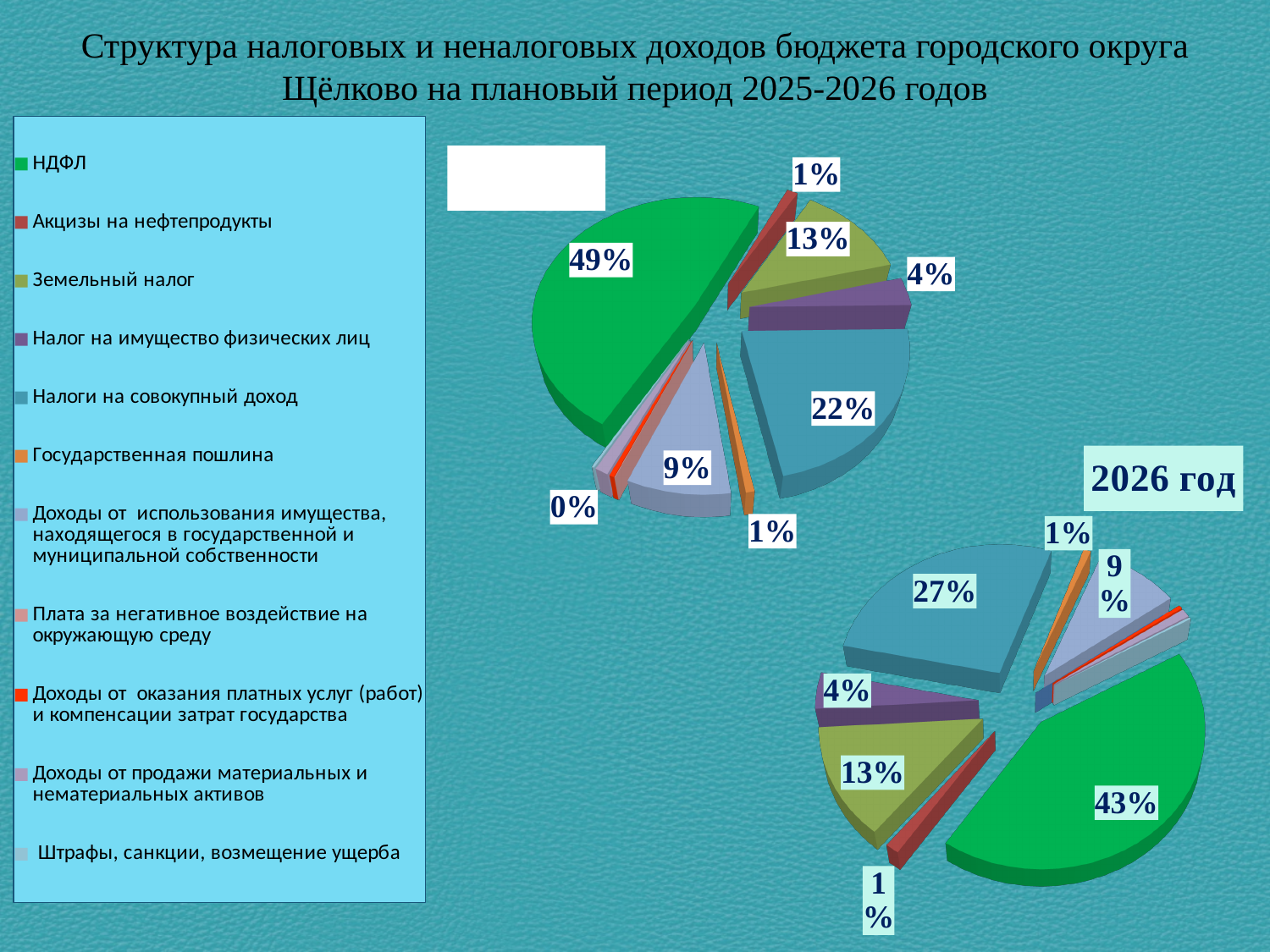
In the "2026 год" chart, what share does НДФЛ have? 43% In the "2026 год" chart, which is larger: Земельный налог or Налог на имущество физических лиц? Земельный налог In the "2026 год" chart, what share does Налоги на совокупный доход have? 27% In the "2026 год" chart, what share does Земельный налог have? 13% In the upper-left pie chart, what share does НДФЛ have? 49% How many categories does the legend list? 11 In the upper-left pie chart, which category has the largest share? НДФЛ What kind of chart is the "2026 год" chart? pie chart In the "2026 год" chart, what is the difference between the shares of НДФЛ and Налоги на совокупный доход? 16 percentage points In the "2026 год" chart, which category has the largest share? НДФЛ In the upper-left pie chart, what share does Налоги на совокупный доход have? 22% What colour represents НДФЛ in the charts? green